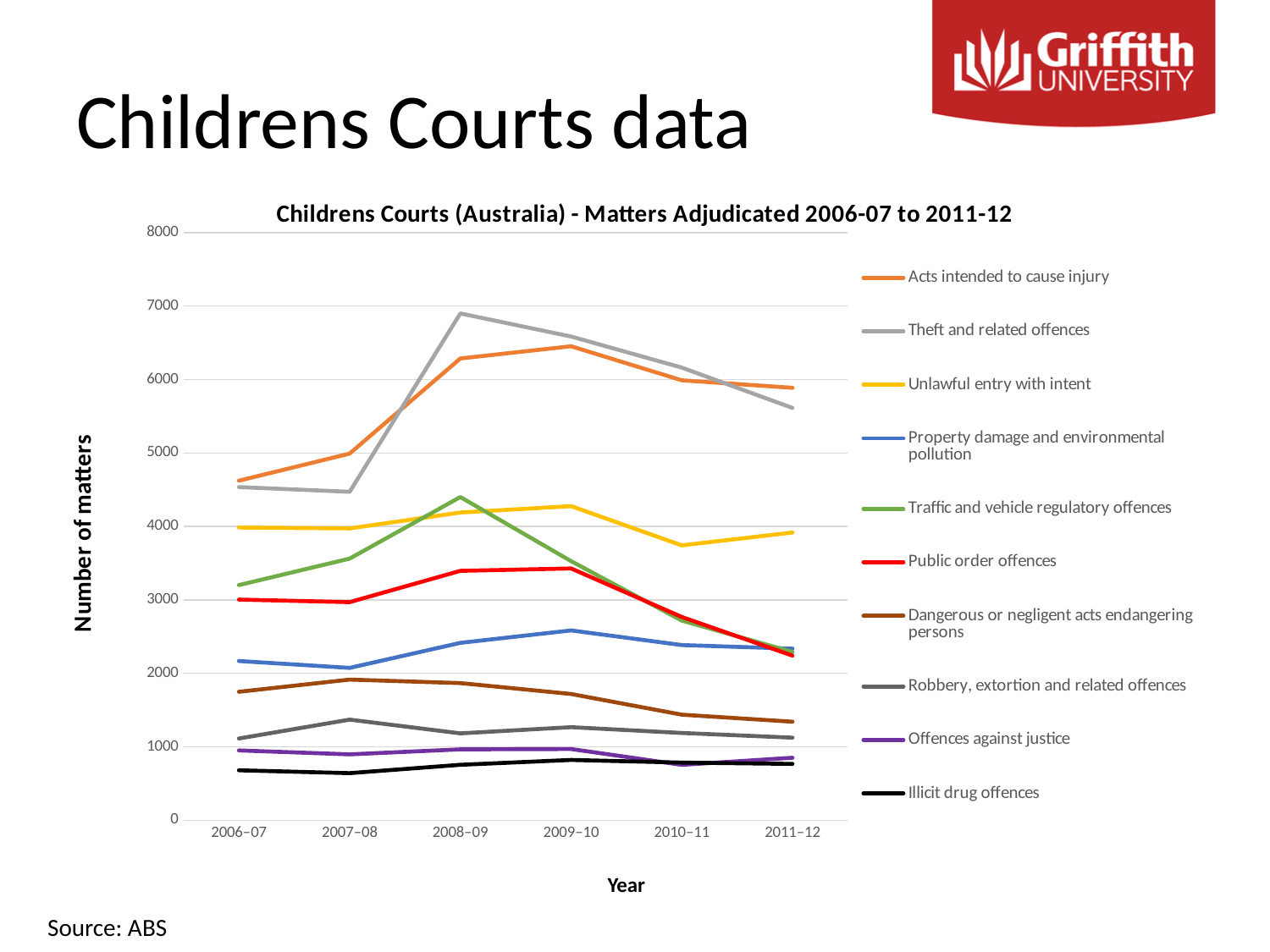
How many years are shown along the x axis? 6 Which offence category has the lowest number of matters in 2006–07? Illicit drug offences What is the label on the vertical axis of the chart? Number of matters How many series does the legend list? 10 Is the value for Unlawful entry with intent in 2010–11 greater or less than 4000? less In 2011–12, which is larger: Acts intended to cause injury or Theft and related offences? Acts intended to cause injury Do the values for Dangerous or negligent acts endangering persons rise or fall from 2007–08 to 2011–12? Fall Is the value for Theft and related offences in 2008–09 greater or less than 6000? greater Which offence category has the highest number of matters in 2008–09? Theft and related offences What is the title of the chart? Childrens Courts (Australia) - Matters Adjudicated 2006-07 to 2011-12 What kind of chart is shown on the slide? Line chart Is the value for Illicit drug offences in 2006–07 greater or less than 1000? less